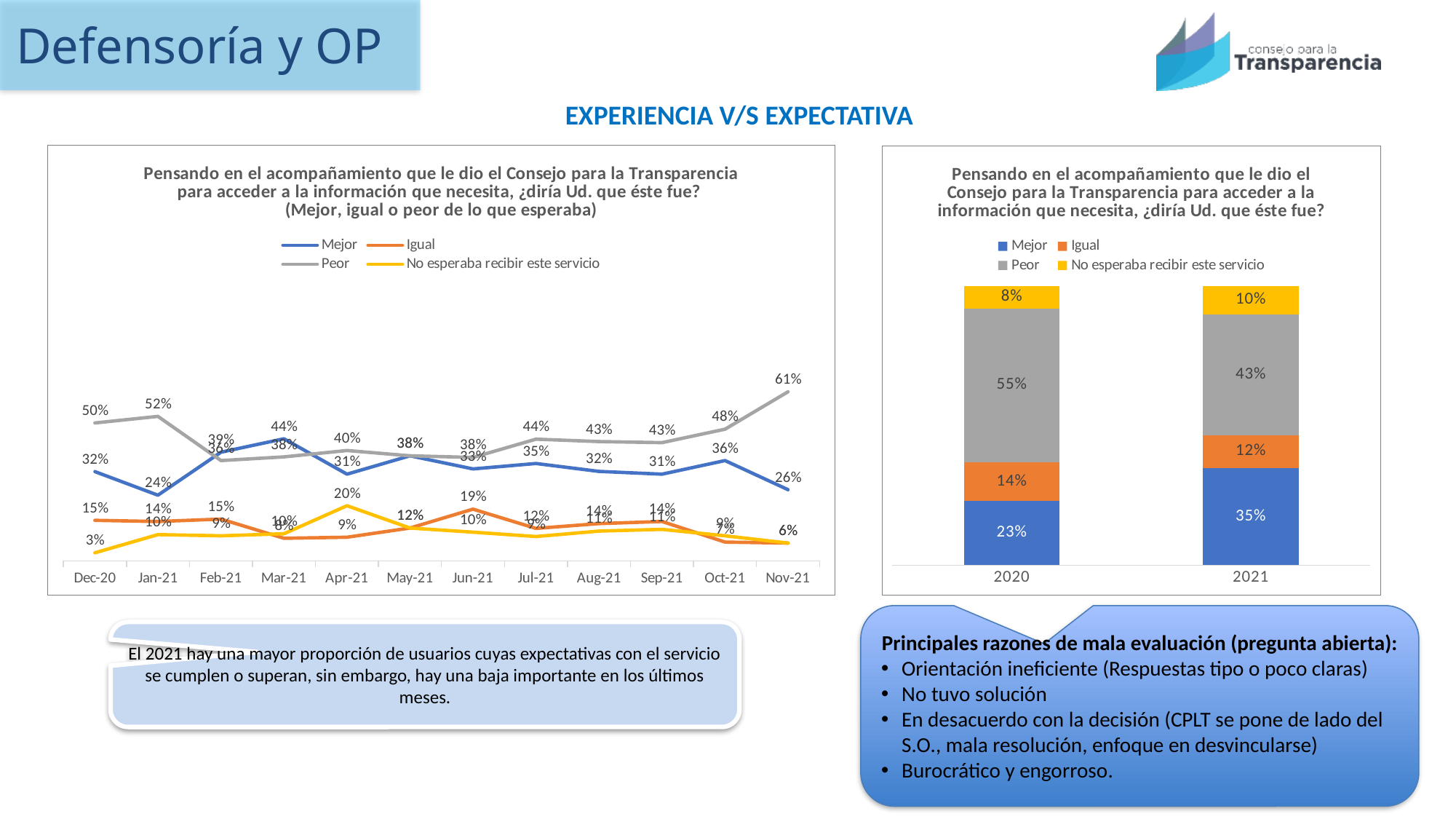
In the right stacked bar chart, which year has the larger Peor value, 2020 or 2021? 2020 What kind of chart is the chart on the right of the slide? bar chart In the left line chart, what is the value for No esperaba recibir este servicio in Apr-21? 20% In the left line chart, how many months are shown on the x axis? 12 In the right stacked bar chart, what is the difference between the Mejor values for 2021 and 2020? 12% In the right stacked bar chart, what is the value for Peor in 2021? 43% In the left line chart, what is the value for Mejor in Dec-20? 32% In the left line chart, what is the value for Peor in Nov-21? 61% In the right stacked bar chart, what is the value for Mejor in 2020? 23% In the left line chart, in which month does Peor reach its highest value? Nov-21 What kind of chart is the chart on the left of the slide? line chart In the left line chart, how many series does the legend list? 4